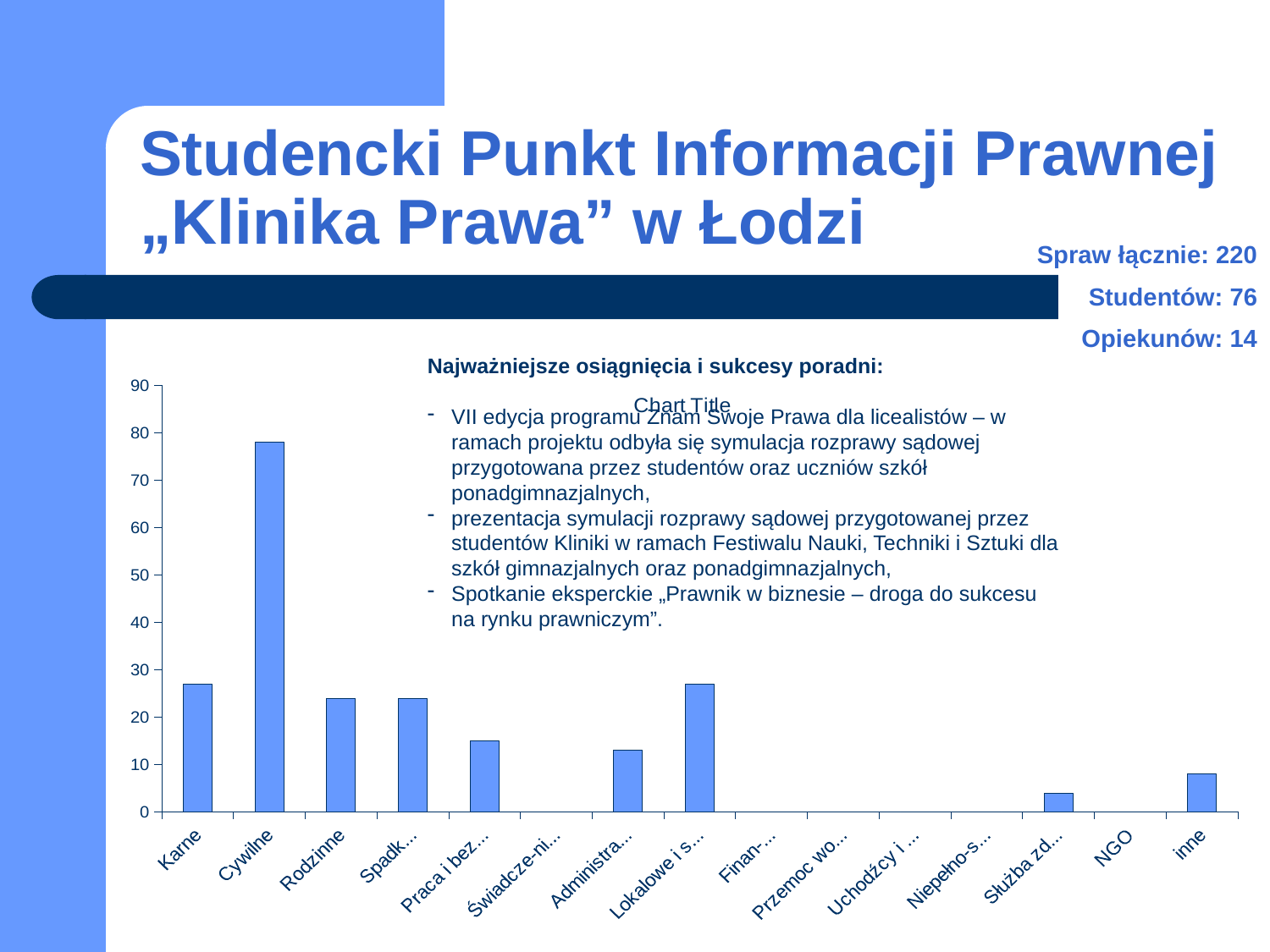
Is the value for inne greater or less than 10? less How many categories are shown on the x axis of the chart? 15 Is the value for Administra... greater or less than 20? less Which is larger, the value for Cywilne or the value for Karne? Cywilne Which category has the highest bar in the chart? Cywilne What kind of chart is shown on the slide? bar chart Is the value for Rodzinne greater or less than 30? less Which is larger, the value for Rodzinne or the value for Praca i bez...? Rodzinne What is the title shown above the chart? Chart Title